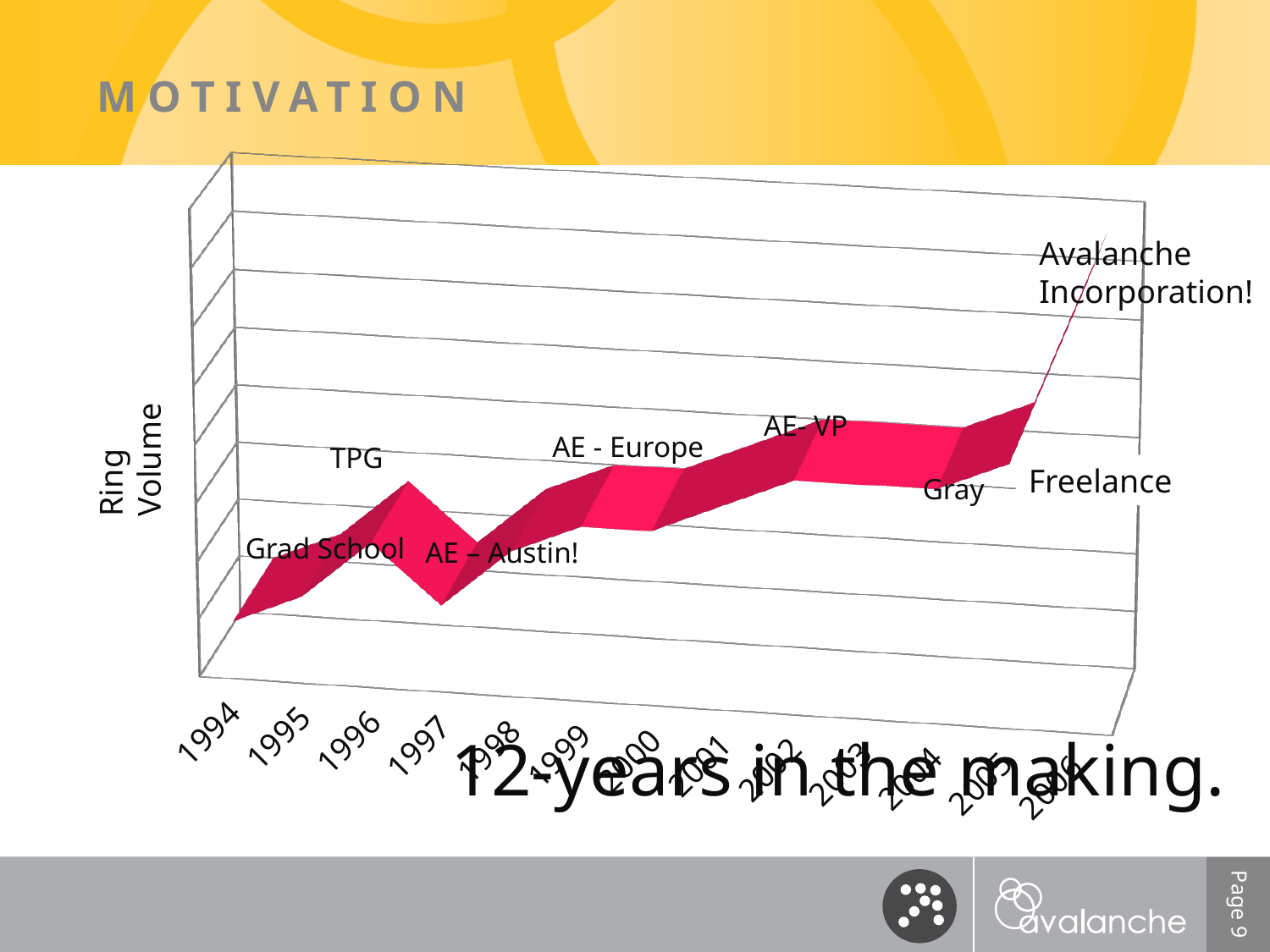
Overall, do the values rise or fall from 1994 to 2006? rise What is the label on the vertical axis of the chart? Ring Volume Which year has the lowest value on the chart? 1994 What kind of chart is shown on the slide? line chart What annotation is placed at the highest point of the chart, in 2006? Avalanche Incorporation! Between 1996 and 1997, does the line rise or fall? fall Which year has the higher value, 1996 or 1997? 1996 How many years are labelled along the x axis of the chart? 13 Which year has the highest value on the chart? 2006 Which year has the higher value, 1999 or 2002? 2002 Which year has the higher value, 1996 or 2002? 2002